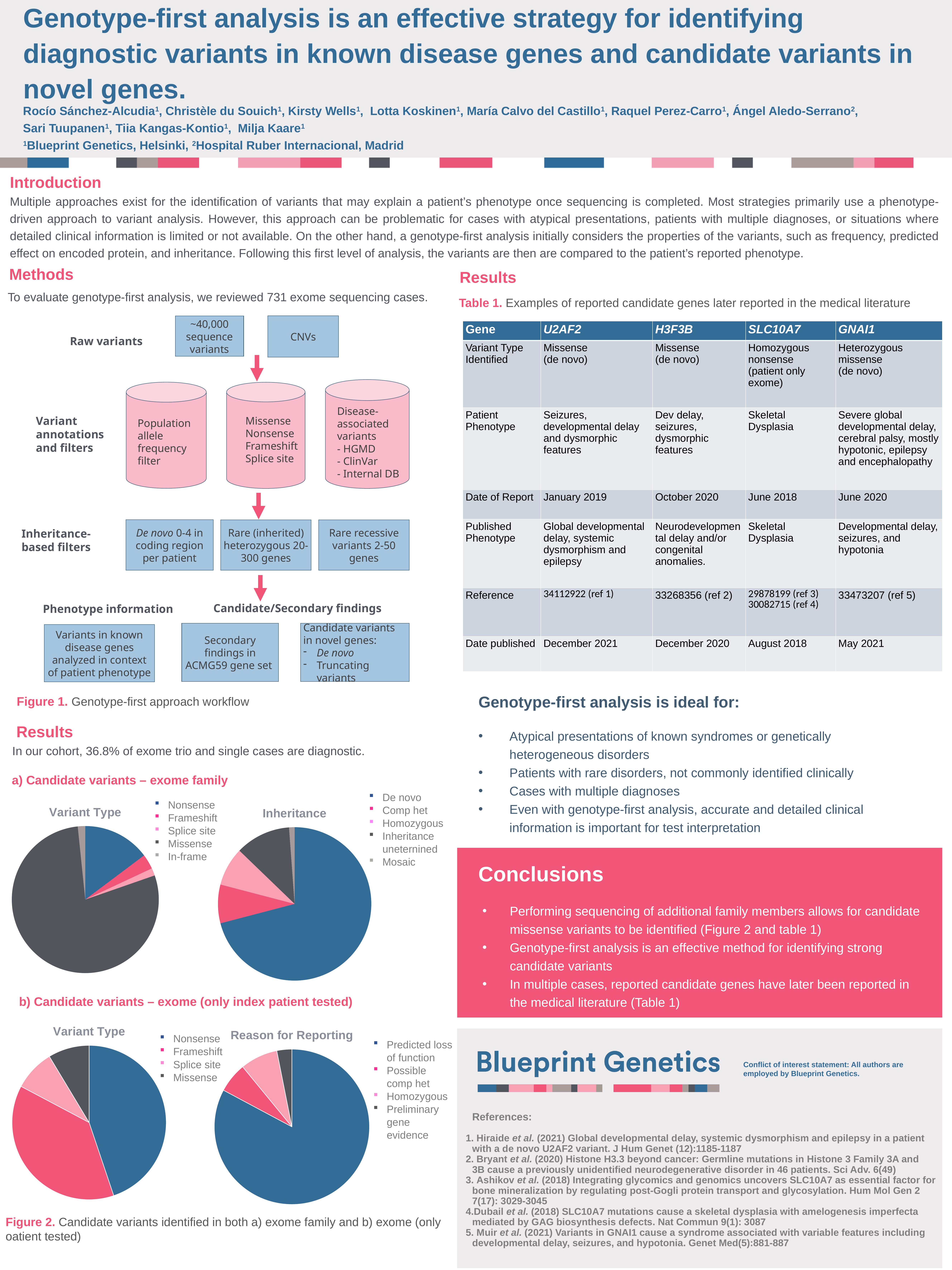
How many categories does the legend of the "Variant Type" pie chart under b) Candidate variants – exome (only index patient tested) list? 4 In the "Reason for Reporting" pie chart under b) Candidate variants – exome (only index patient tested), which slice is larger: Predicted loss of function or Homozygous? Predicted loss of function How many categories does the legend of the "Inheritance" pie chart under a) Candidate variants – exome family list? 5 In the "Variant Type" pie chart under a) Candidate variants – exome family, which variant type has the largest slice? Missense What kind of chart is the "Variant Type" chart under a) Candidate variants – exome family? Pie chart How many categories does the legend of the "Variant Type" pie chart under a) Candidate variants – exome family list? 5 In the "Reason for Reporting" pie chart under b) Candidate variants – exome (only index patient tested), which reason has the largest slice? Predicted loss of function In the "Variant Type" pie chart under b) Candidate variants – exome (only index patient tested), which variant type has the largest slice? Nonsense In the "Variant Type" pie chart under a) Candidate variants – exome family, which slice is larger: Missense or Nonsense? Missense How many pie charts are shown in Figure 2 on the slide? 4 In the "Inheritance" pie chart under a) Candidate variants – exome family, which slice is larger: De novo or Homozygous? De novo